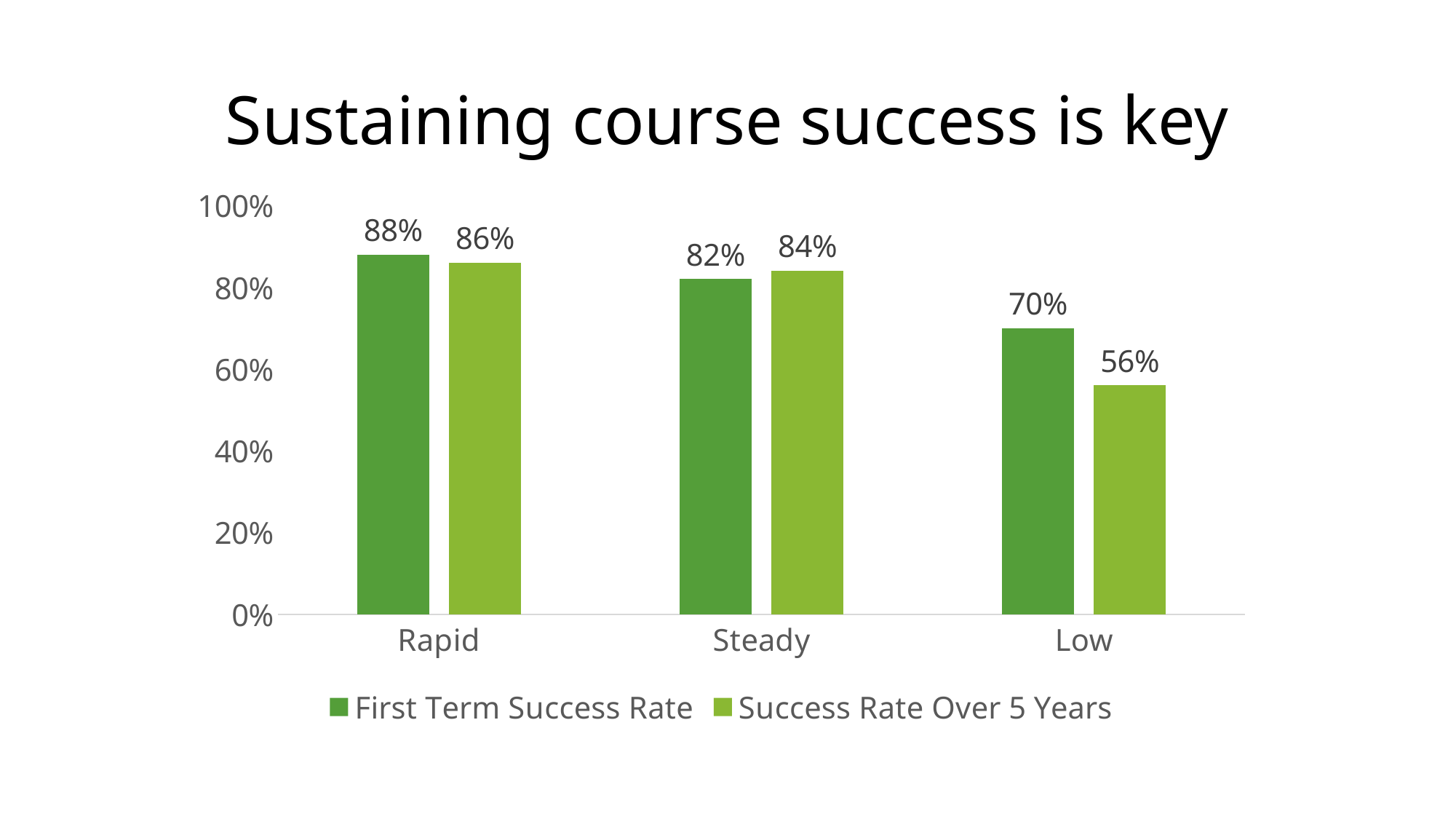
Which category has the lowest Success Rate Over 5 Years? Low Is the Success Rate Over 5 Years for Low greater or less than 60%? less How many categories are shown on the x axis? 3 How many series does the legend list? 2 What kind of chart is shown on the slide? bar chart What is the Success Rate Over 5 Years for Low? 56% What is the title of the slide? Sustaining course success is key What is the difference between the First Term Success Rate and the Success Rate Over 5 Years for Low? 14% What is the Success Rate Over 5 Years for Steady? 84% For Steady, which is larger: the First Term Success Rate or the Success Rate Over 5 Years? Success Rate Over 5 Years What is the First Term Success Rate for Rapid? 88% Which category has the highest First Term Success Rate? Rapid